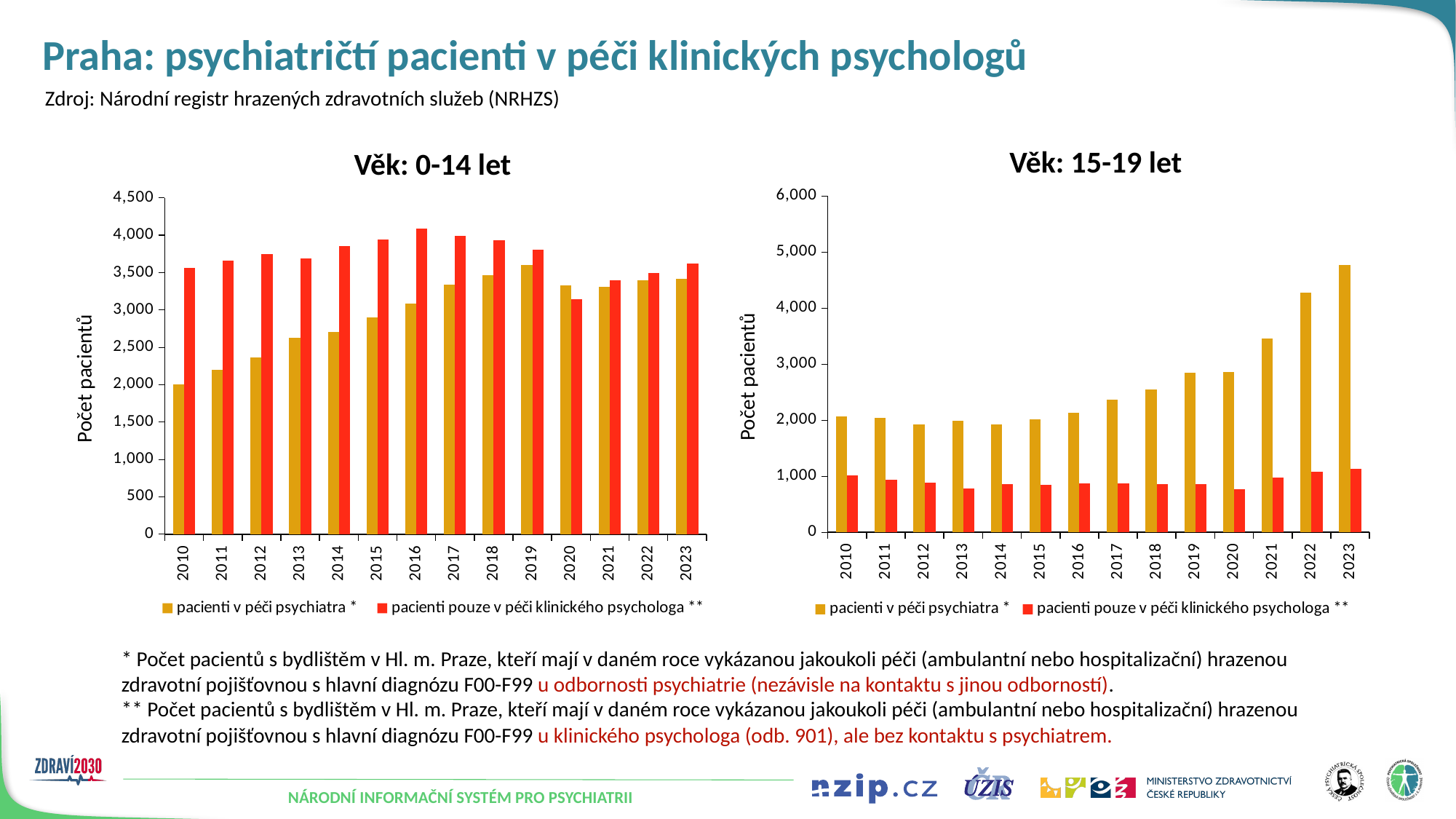
In the 'Věk: 15-19 let' chart, which year has the highest value for 'pacienti v péči psychiatra *'? 2023 How many series does the legend of the 'Věk: 0-14 let' chart list? 2 How many years are shown on the x axis of the 'Věk: 15-19 let' chart? 14 In the 'Věk: 15-19 let' chart, does the 'pacienti v péči psychiatra *' series rise or fall from 2017 to 2023? rise In the 'Věk: 0-14 let' chart, is the 2010 value for 'pacienti v péči psychiatra *' greater or less than 2,500? less What is the y-axis label of the 'Věk: 15-19 let' chart? Počet pacientů In the 'Věk: 15-19 let' chart, is the 2023 value for 'pacienti v péči psychiatra *' greater or less than 4,000? greater In the 'Věk: 0-14 let' chart, which year has the highest value for 'pacienti v péči psychiatra *'? 2019 In the 'Věk: 0-14 let' chart, which year has the lowest value for 'pacienti v péči psychiatra *'? 2010 In the 'Věk: 0-14 let' chart, which year has the highest value for 'pacienti pouze v péči klinického psychologa **'? 2016 What kind of chart is the 'Věk: 0-14 let' chart? bar chart In the 'Věk: 0-14 let' chart, which series has the larger value in 2010? pacienti pouze v péči klinického psychologa **